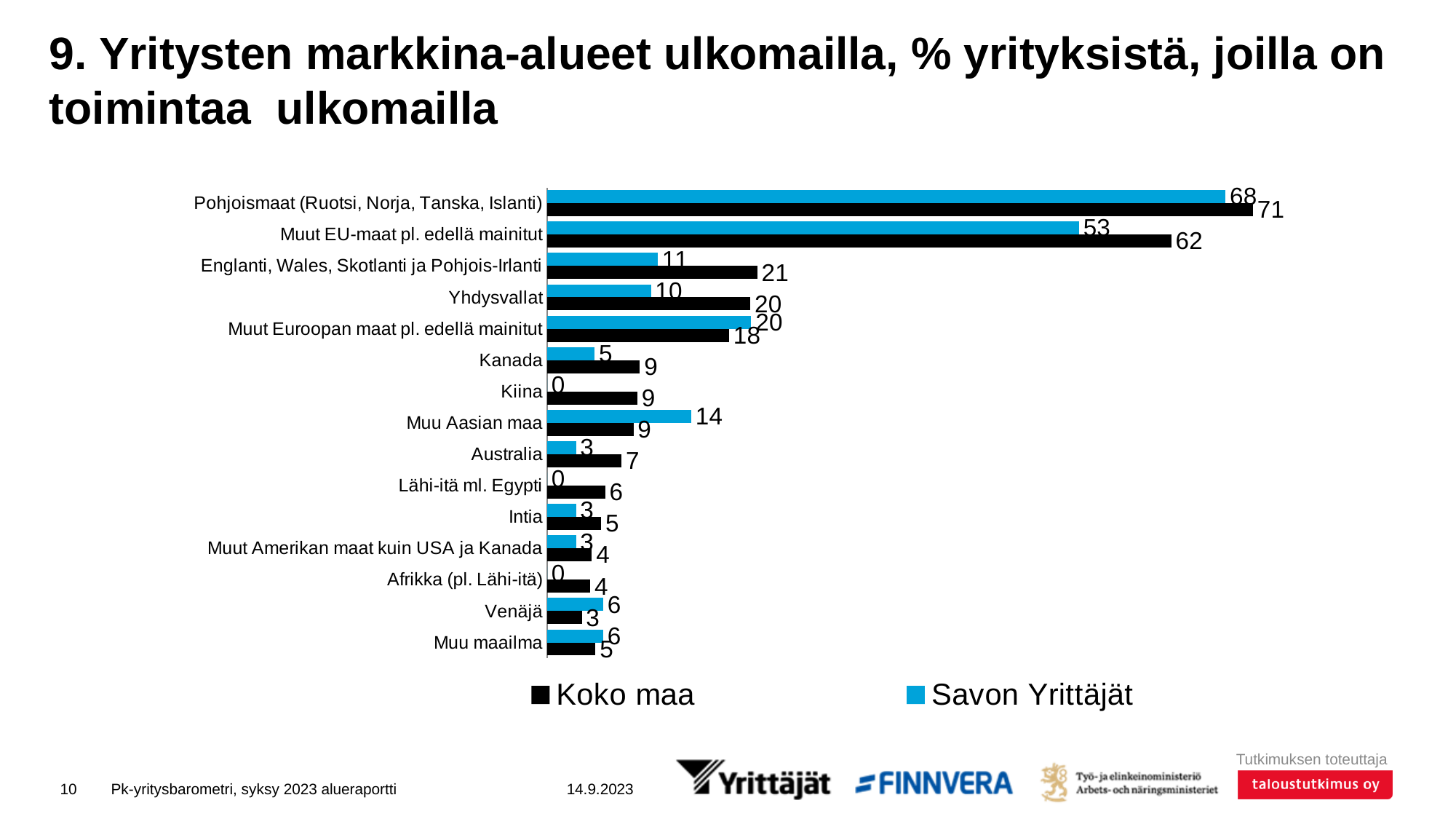
For Venäjä, which series has the larger value, Koko maa or Savon Yrittäjät? Savon Yrittäjät What is the Savon Yrittäjät value for Muu Aasian maa? 14 How many series does the legend list? 2 Which colour represents the Savon Yrittäjät series? Blue How many categories are shown on the chart? 15 What is the Koko maa value for Yhdysvallat? 20 What is the Koko maa value for Pohjoismaat (Ruotsi, Norja, Tanska, Islanti)? 71 What is the Savon Yrittäjät value for Muut EU-maat pl. edellä mainitut? 53 Which category has the highest Koko maa value? Pohjoismaat (Ruotsi, Norja, Tanska, Islanti) What kind of chart is shown on the slide? Bar chart For Muut Euroopan maat pl. edellä mainitut, which series has the larger value, Koko maa or Savon Yrittäjät? Savon Yrittäjät What is the difference between the Koko maa and Savon Yrittäjät values for Englanti, Wales, Skotlanti ja Pohjois-Irlanti? 10